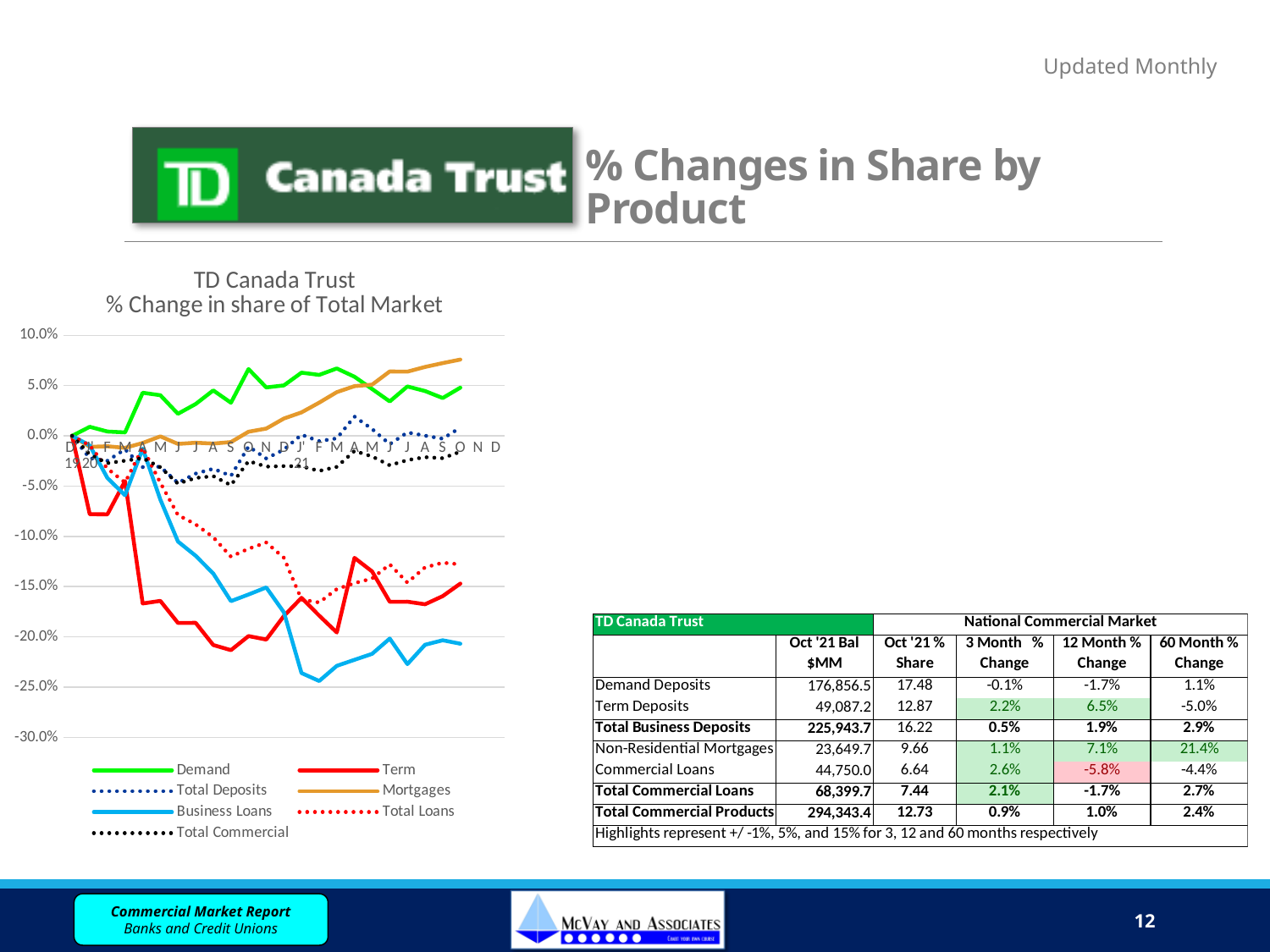
Which series in the chart is drawn in orange? Mortgages Does the Business Loans series generally rise or fall along the x axis? fall How many series does the chart legend list? 7 Which series reaches the lowest value on the chart? Business Loans What type of chart is shown on the slide? line chart Is the lowest value reached by the Business Loans series greater or less than -20.0%? less Does the Mortgages series generally rise or fall along the x axis? rise What is the title of the chart? TD Canada Trust % Change in share of Total Market